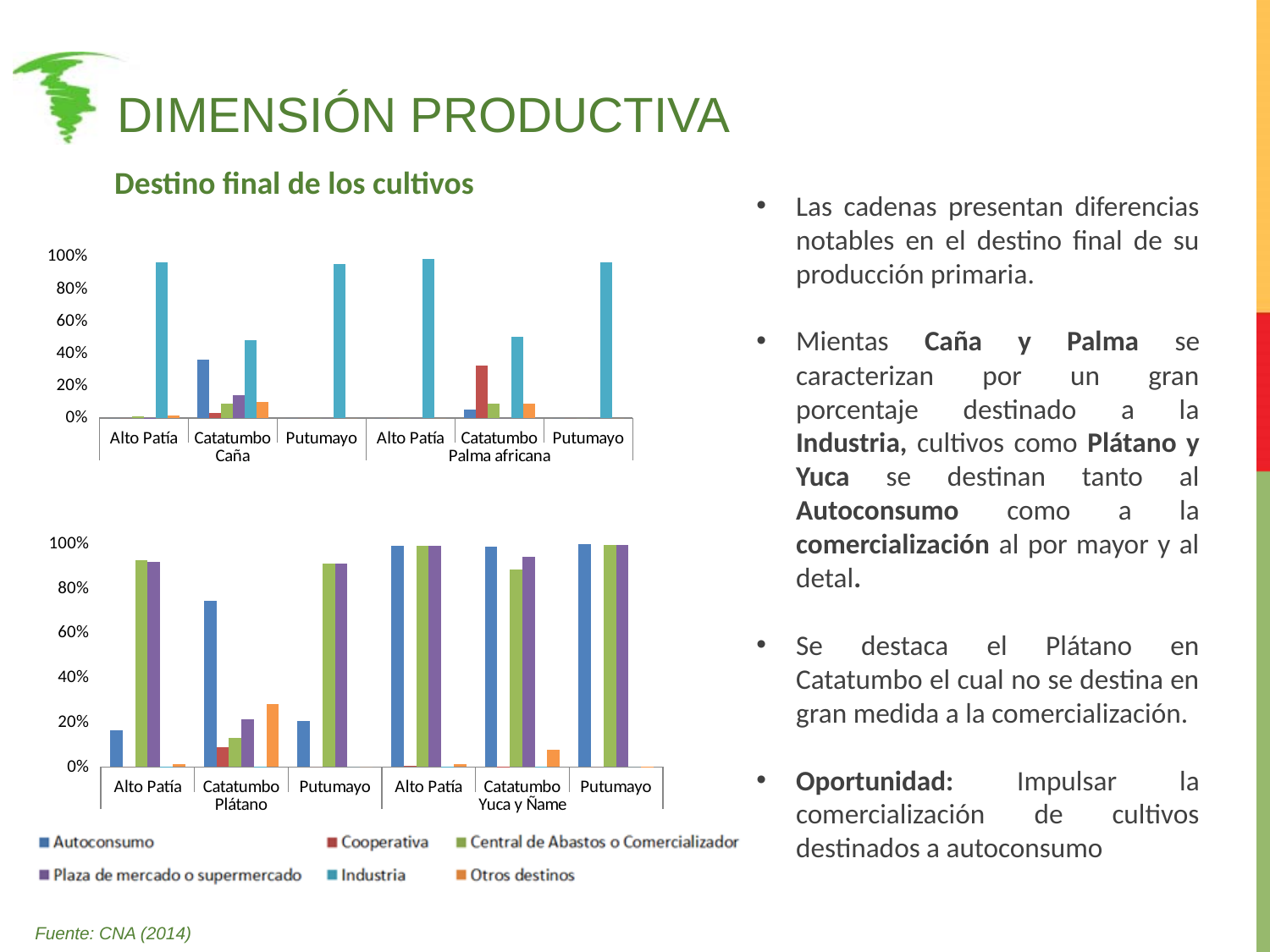
In the top chart, which region has the lowest Industria value for Caña? Catatumbo In the bottom chart, for Catatumbo under Plátano, which is larger: Otros destinos or Plaza de mercado o supermercado? Otros destinos In the bottom chart, is the Autoconsumo value for Catatumbo under Plátano greater or less than 60%? greater In the bottom chart, which region has the highest Autoconsumo value for Plátano? Catatumbo In the top chart, how many region categories are plotted in total across Caña and Palma africana? 6 What is the title shown above the charts? Destino final de los cultivos In the top chart, for Catatumbo under Caña, which is larger: Autoconsumo or Industria? Industria In the bottom chart, is the Autoconsumo value for Alto Patía under Plátano greater or less than 40%? less How many series does the legend list? 6 In the top chart, is the Industria value for Catatumbo under Caña greater or less than 60%? less What type of chart is used on this slide? bar chart